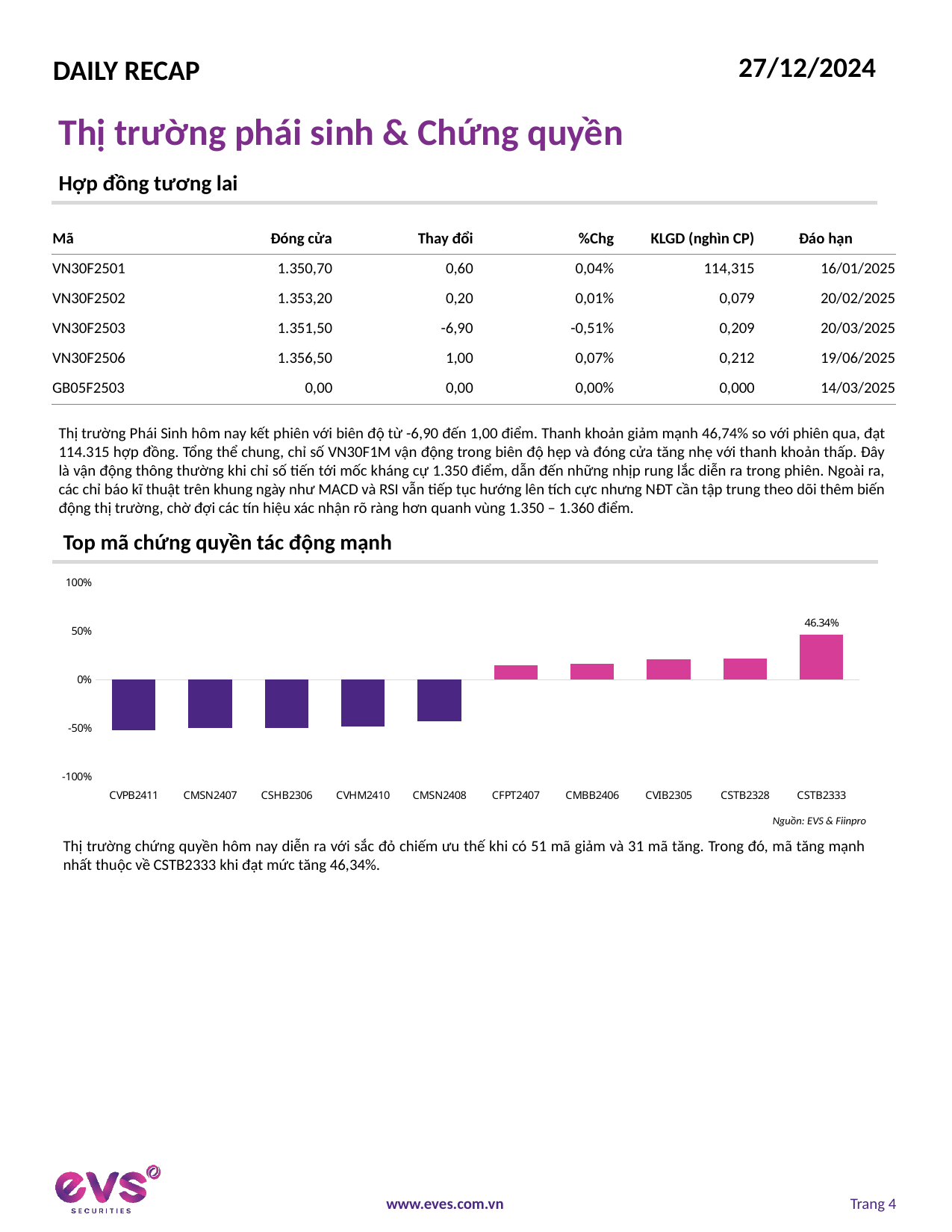
In the 'Top mã chứng quyền tác động mạnh' chart, which has the larger value, CVPB2411 or CSTB2328? CSTB2328 What type of chart is shown under 'Top mã chứng quyền tác động mạnh'? Bar chart In the 'Top mã chứng quyền tác động mạnh' chart, is the value for CMSN2408 greater or less than 0%? less How many warrant codes are shown on the x axis of the 'Top mã chứng quyền tác động mạnh' chart? 10 In the 'Top mã chứng quyền tác động mạnh' chart, do the values rise or fall from left to right along the x axis? Rise In the 'Top mã chứng quyền tác động mạnh' chart, which has the larger value, CSTB2333 or CFPT2407? CSTB2333 In the 'Top mã chứng quyền tác động mạnh' chart, is the value for CVPB2411 greater or less than 0%? less What source is cited below the 'Top mã chứng quyền tác động mạnh' chart? EVS & Fiinpro In the 'Top mã chứng quyền tác động mạnh' chart, what is the value shown for CSTB2333? 46.34% Which warrant code has the highest value in the 'Top mã chứng quyền tác động mạnh' chart? CSTB2333 In the 'Top mã chứng quyền tác động mạnh' chart, is the value for CFPT2407 greater or less than 50%? less